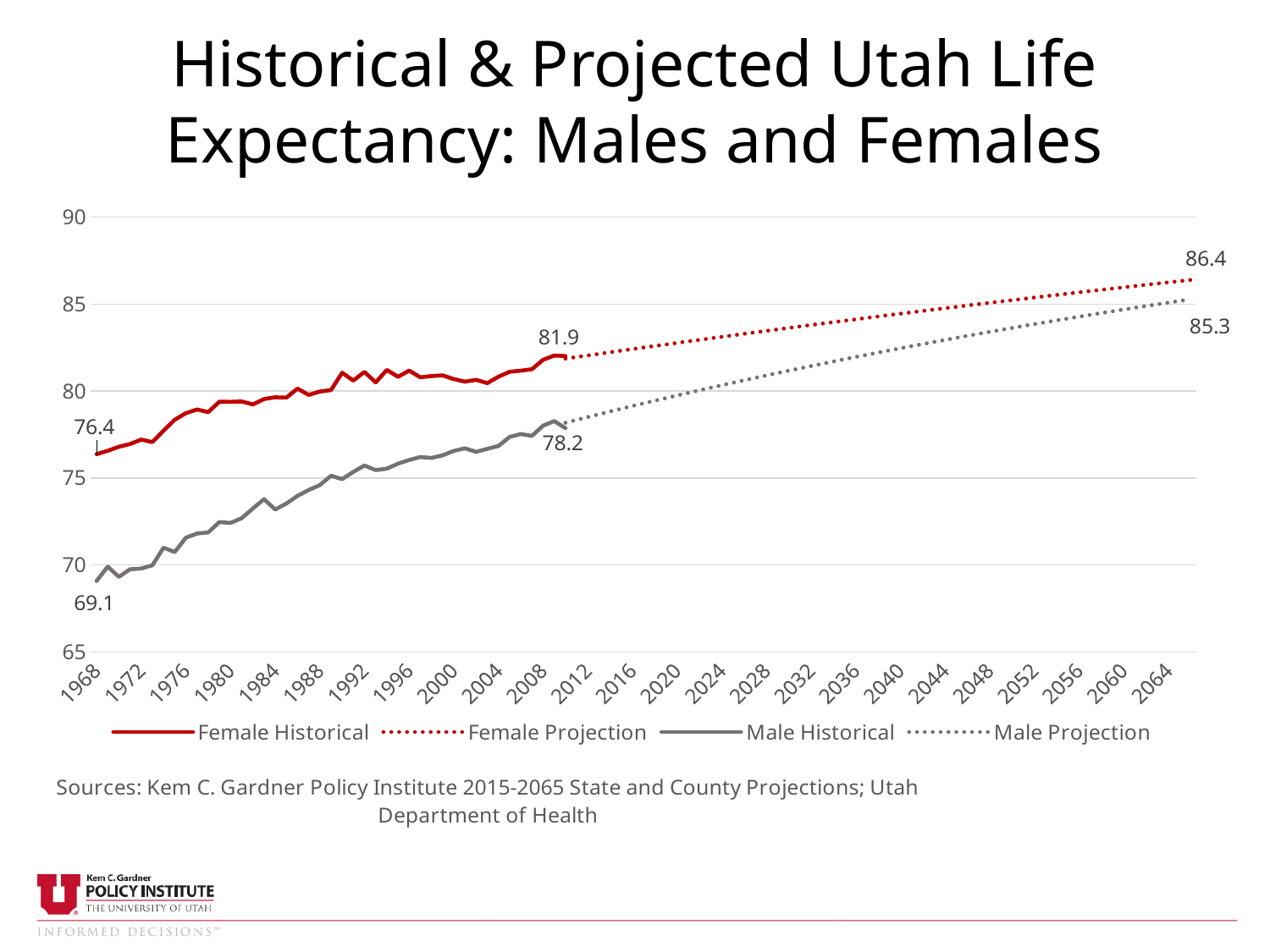
What is the male life expectancy value labelled at the start of the Male Historical line in 1968? 69.1 What is the female life expectancy value labelled at the start of the Female Historical line in 1968? 76.4 How many series does the legend list? 4 What is the difference between the labelled female and male life expectancy values in 1968 (76.4 and 69.1)? 7.3 What type of chart is shown on the slide? line chart What is the projected male life expectancy labelled at the end of the Male Projection line? 85.3 Do the life expectancy values rise or fall along the x axis from 1968 to 2064? rise What is the difference between the final projected female value (86.4) and the final projected male value (85.3)? 1.1 Which is larger, the end-of-historical female value (81.9) or the end-of-historical male value (78.2)? 81.9 (female) What is the value labelled at the end of the Female Historical line? 81.9 What is the projected female life expectancy labelled at the end of the Female Projection line? 86.4 What is the title of the chart on the slide? Historical & Projected Utah Life Expectancy: Males and Females